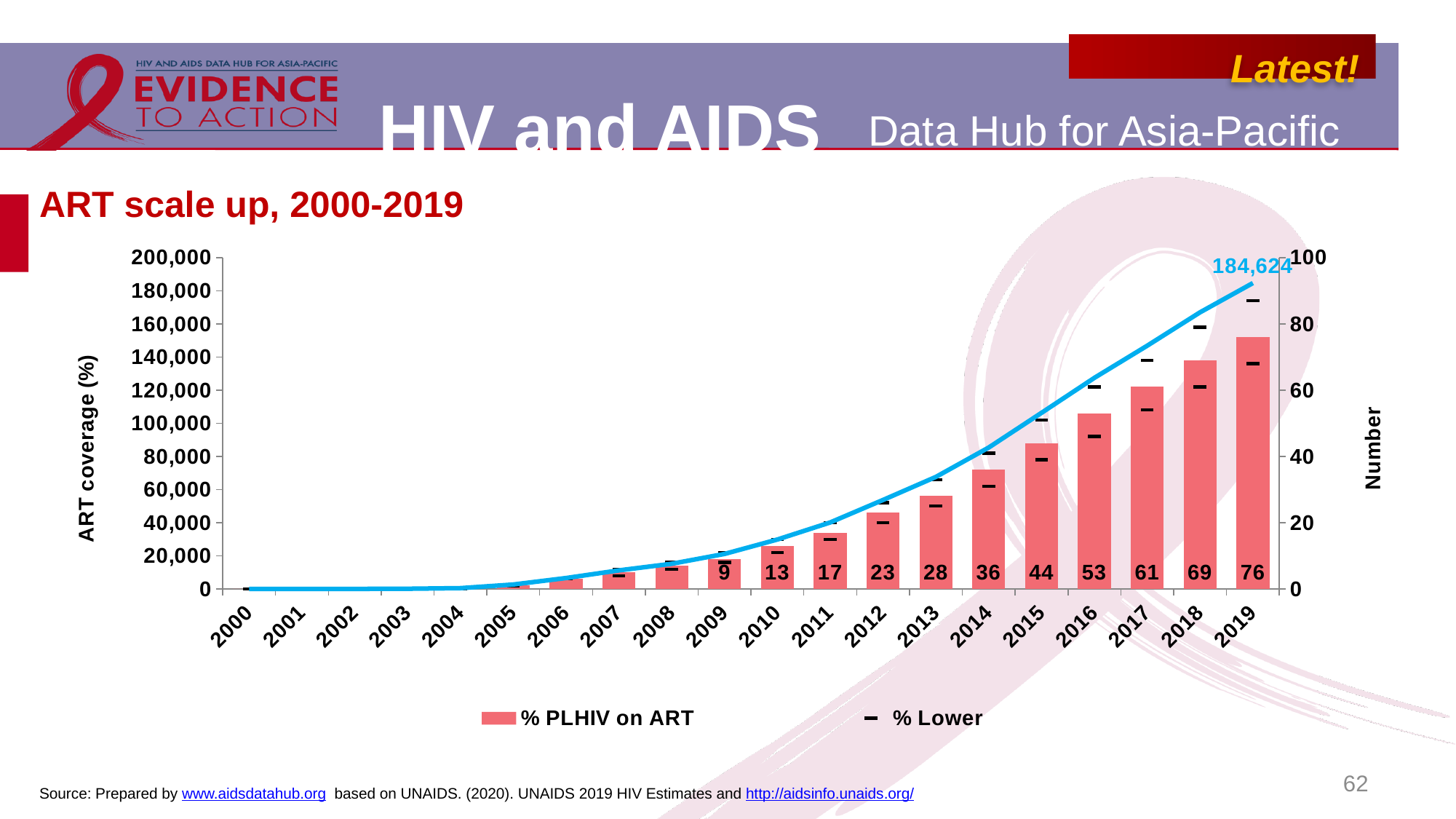
What is the % PLHIV on ART value for 2009? 9 What is the difference in % PLHIV on ART between 2019 and 2018? 7 What is the % PLHIV on ART value for 2019? 76 What number is labelled on the blue line at 2019? 184,624 Do the % PLHIV on ART bars rise or fall from 2009 to 2019? rise Which year has a higher % PLHIV on ART, 2014 or 2011? 2014 How many years are shown on the x axis? 20 What is the difference in % PLHIV on ART between 2016 and 2013? 25 What is the % PLHIV on ART value for 2012? 23 How many entries does the legend list? 2 Which year has the highest % PLHIV on ART? 2019 Is the number on the blue line for 2015 greater or less than 80,000? greater